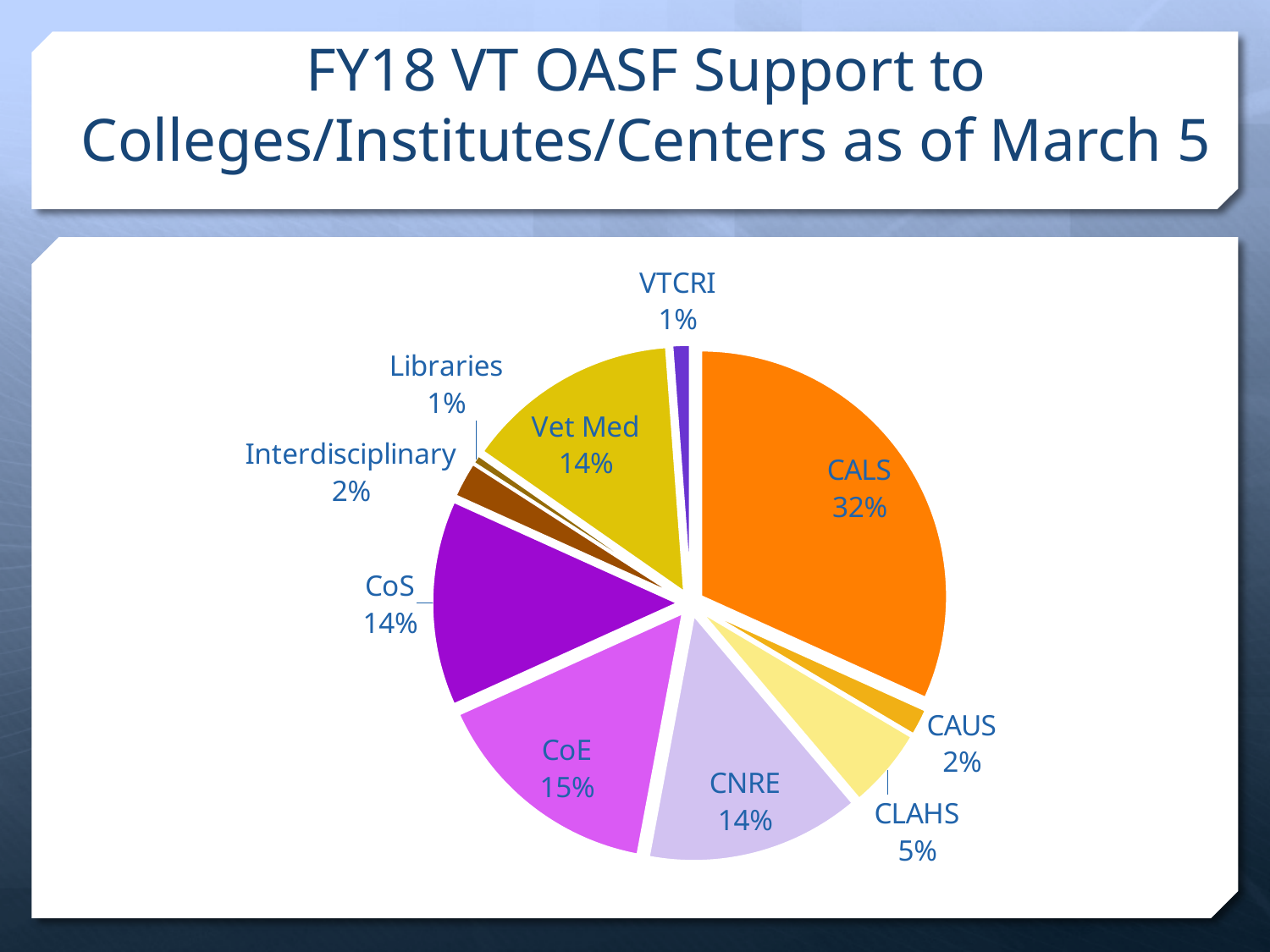
What is the difference in percentage points between CLAHS and CAUS? 3% What percentage is shown for Interdisciplinary? 2% What percentage is shown for CLAHS? 5% What kind of chart is shown on the slide? pie chart What share of FY18 VT OASF support went to CALS? 32% How many categories are labeled on the pie chart? 10 What is the title of the slide? FY18 VT OASF Support to Colleges/Institutes/Centers as of March 5 Which category has the largest slice of the pie? CALS What percentage is shown for CoE? 15% What is the difference in percentage points between CALS and CoE? 17% Which has the larger share, CoE or CNRE? CoE What percentage is shown for Vet Med? 14%